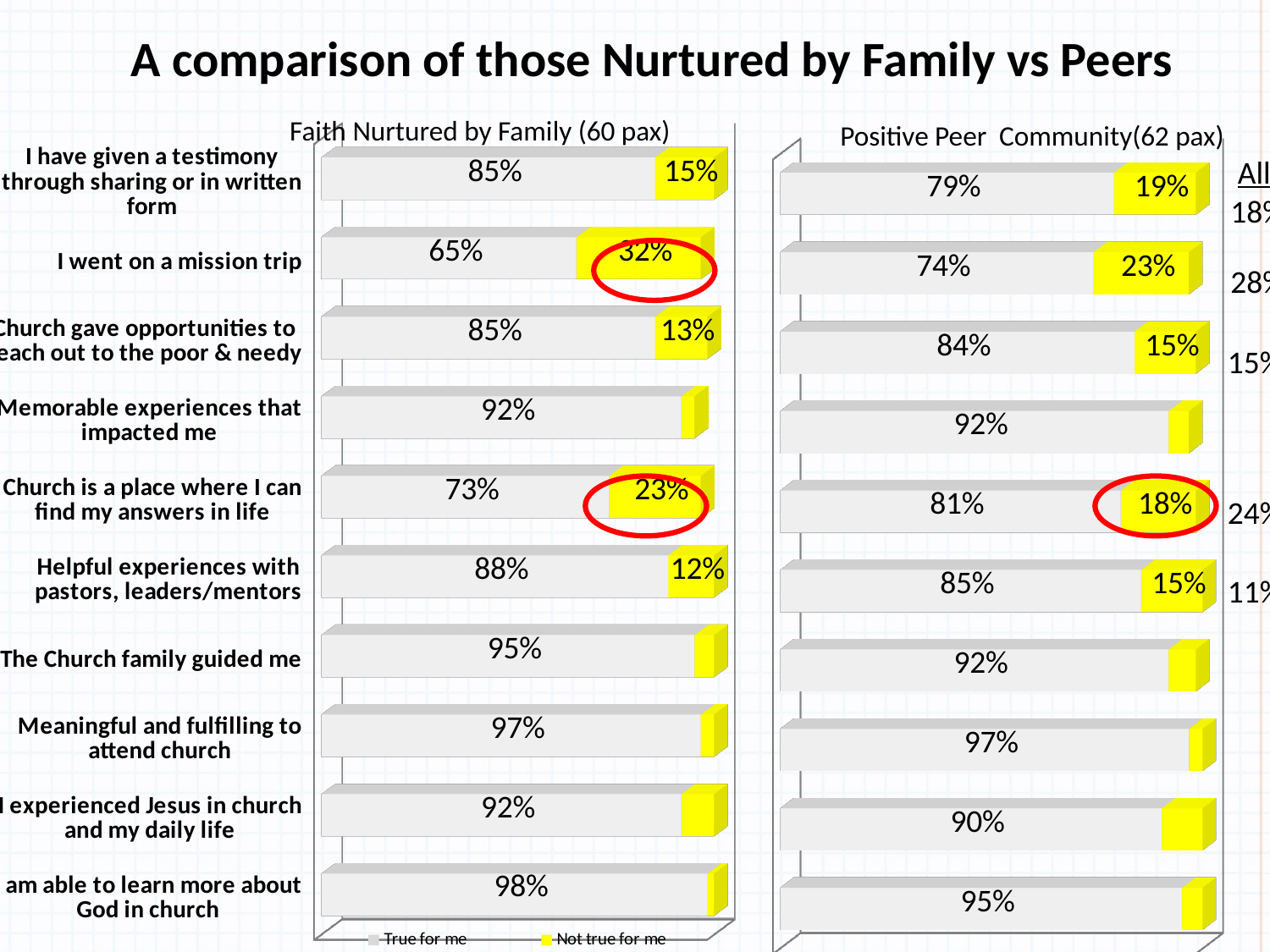
In the Faith Nurtured by Family chart, which category has the highest 'True for me' percentage? I am able to learn more about God in church What type of chart is the Positive Peer Community chart? Stacked bar chart In the Faith Nurtured by Family chart, what percentage is 'True for me' for 'I went on a mission trip'? 65% In the Positive Peer Community chart, what percentage is 'Not true for me' for 'I went on a mission trip'? 23% What is the difference between the 'True for me' values for 'I went on a mission trip' in the Faith Nurtured by Family chart and the Positive Peer Community chart? 9% For 'Helpful experiences with pastors, leaders/mentors', which chart shows a higher 'True for me' value, Faith Nurtured by Family or Positive Peer Community? Faith Nurtured by Family In the Positive Peer Community chart, which category has the lowest 'True for me' percentage? I went on a mission trip How many series does the legend of the Faith Nurtured by Family chart list? 2 How many categories are shown in the Faith Nurtured by Family chart? 10 In the Positive Peer Community chart, what is the 'True for me' value for 'I have given a testimony through sharing or in written form'? 79% In the Faith Nurtured by Family chart, which category has the lowest 'True for me' percentage? I went on a mission trip In the Faith Nurtured by Family chart, what is the 'True for me' value for 'Church is a place where I can find my answers in life'? 73%